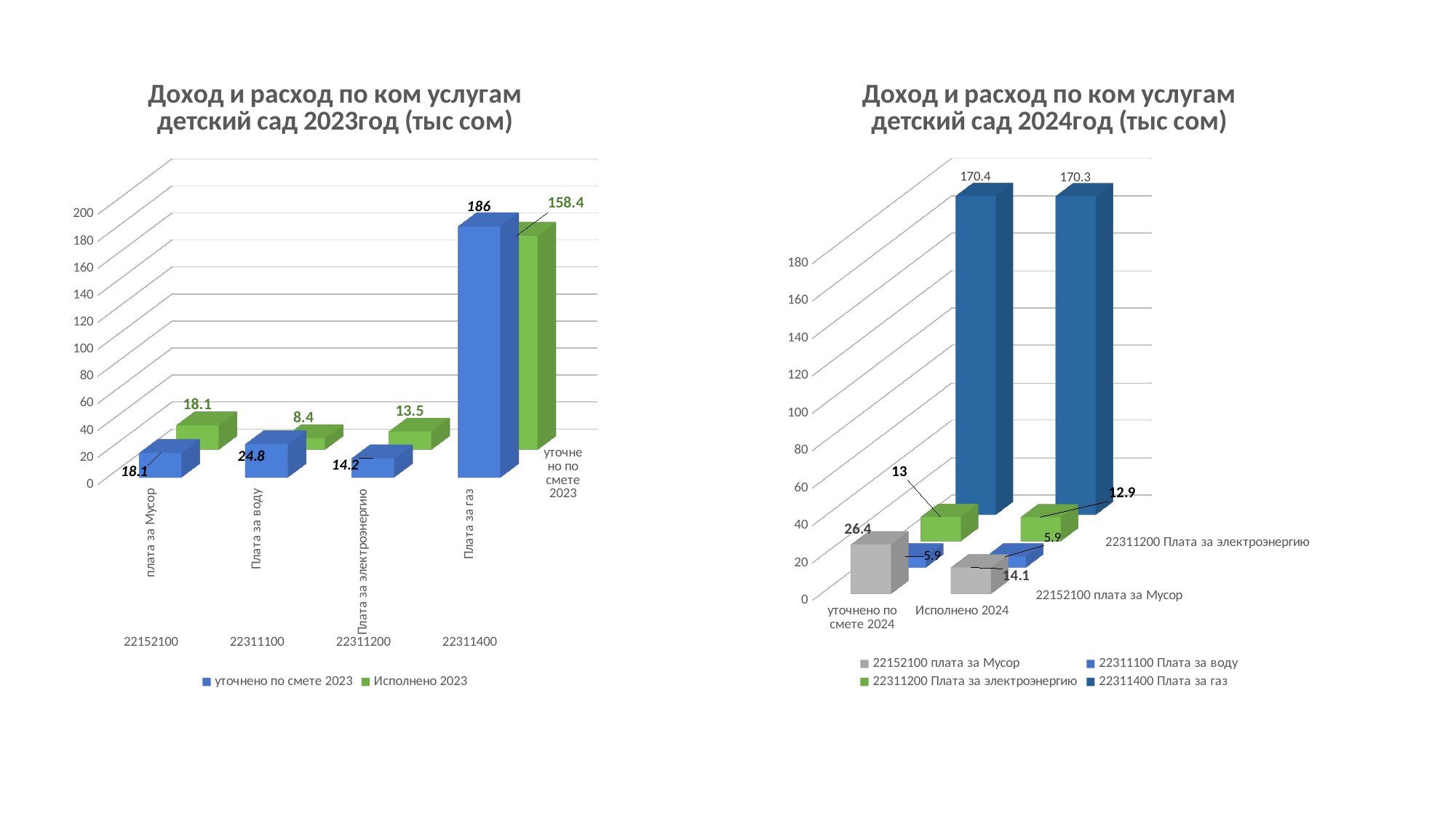
In the 2024 chart (right), how many series does the legend list? 4 In the 2024 chart (right), what is the difference between 'уточнено по смете 2024' and 'Исполнено 2024' for плата за Мусор? 12.3 In the 2024 chart (right), which is larger for 'Исполнено 2024': плата за Мусор or Плата за воду? плата за Мусор In the 2023 chart (left), which category has the highest 'Исполнено 2023' value? Плата за газ In the 2023 chart (left), what is the difference between 'уточнено по смете 2023' and 'Исполнено 2023' for Плата за газ? 27.6 In the 2024 chart (right), what is the value of '22311400 Плата за газ' for 'Исполнено 2024'? 170.3 In the 2023 chart (left), which category has the lowest 'Исполнено 2023' value? Плата за воду In the 2023 chart (left), what is the value of 'уточнено по смете 2023' for Плата за газ? 186 What kind of chart is the 2024 chart on the right? Bar chart In the 2023 chart (left), what is the value of 'Исполнено 2023' for Плата за воду? 8.4 In the 2023 chart (left), how many series does the legend list? 2 In the 2024 chart (right), what is the value of '22152100 плата за Мусор' for 'уточнено по смете 2024'? 26.4